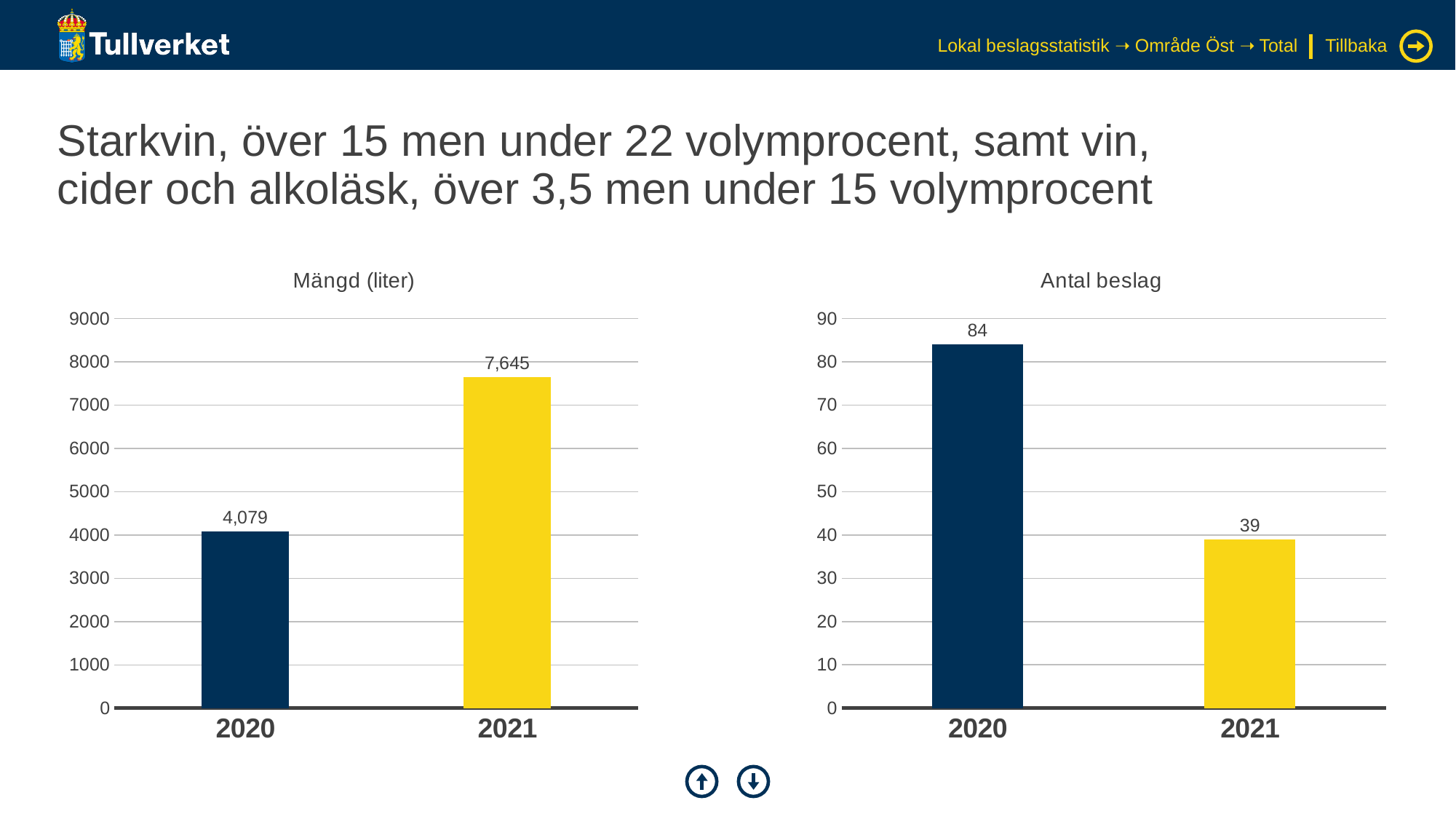
In the 'Mängd (liter)' chart, what is the value for 2020? 4,079 In the 'Antal beslag' chart, what is the value for 2021? 39 In the 'Antal beslag' chart, do the values rise or fall from 2020 to 2021? fall In the 'Mängd (liter)' chart, how many years are shown on the x axis? 2 In the 'Antal beslag' chart, what is the difference between the 2020 and 2021 values? 45 In the 'Mängd (liter)' chart, what is the value for 2021? 7,645 In the 'Antal beslag' chart, is the value for 2020 greater or less than 80? greater In the 'Antal beslag' chart, what is the value for 2020? 84 In the 'Antal beslag' chart, which year has the lowest value? 2021 In the 'Mängd (liter)' chart, which year has the highest value? 2021 What kind of chart is the 'Antal beslag' chart? bar chart In the 'Mängd (liter)' chart, what is the difference between the 2021 and 2020 values? 3,566